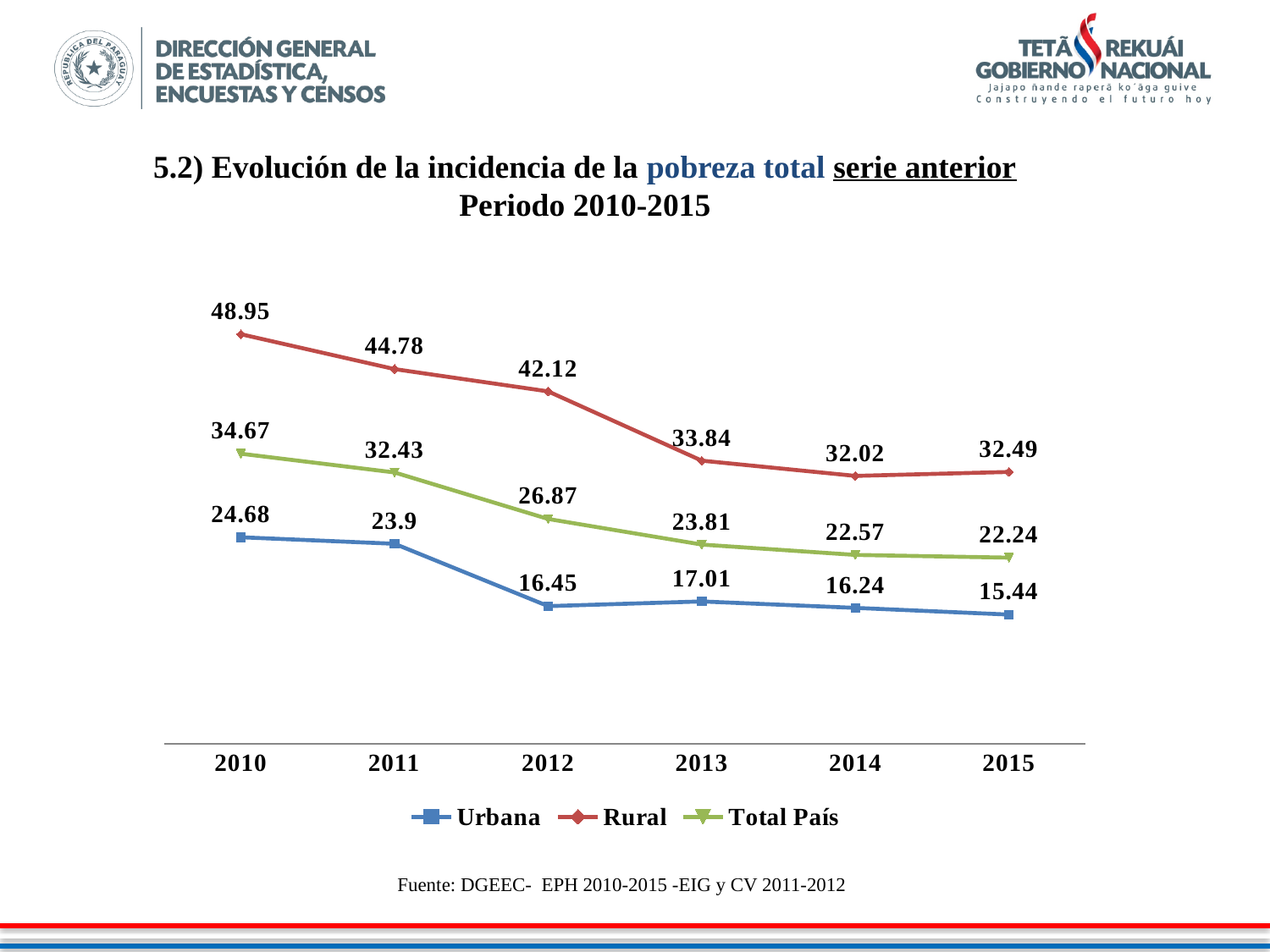
What is the Urbana value for 2015? 15.44 How many years are shown on the x axis? 6 In which year is the Urbana series highest? 2010 What is the Rural value for 2010? 48.95 Does the Total País series rise or fall from 2010 to 2015? Fall In which year is the Rural series lowest? 2014 Which is larger in 2011: the Rural value or the Total País value? Rural What is the difference between the Rural and Urbana values in 2013? 16.83 What is the Total País value for 2012? 26.87 What kind of chart is shown on the slide? Line chart How many series does the legend list? 3 Which series is drawn in red? Rural